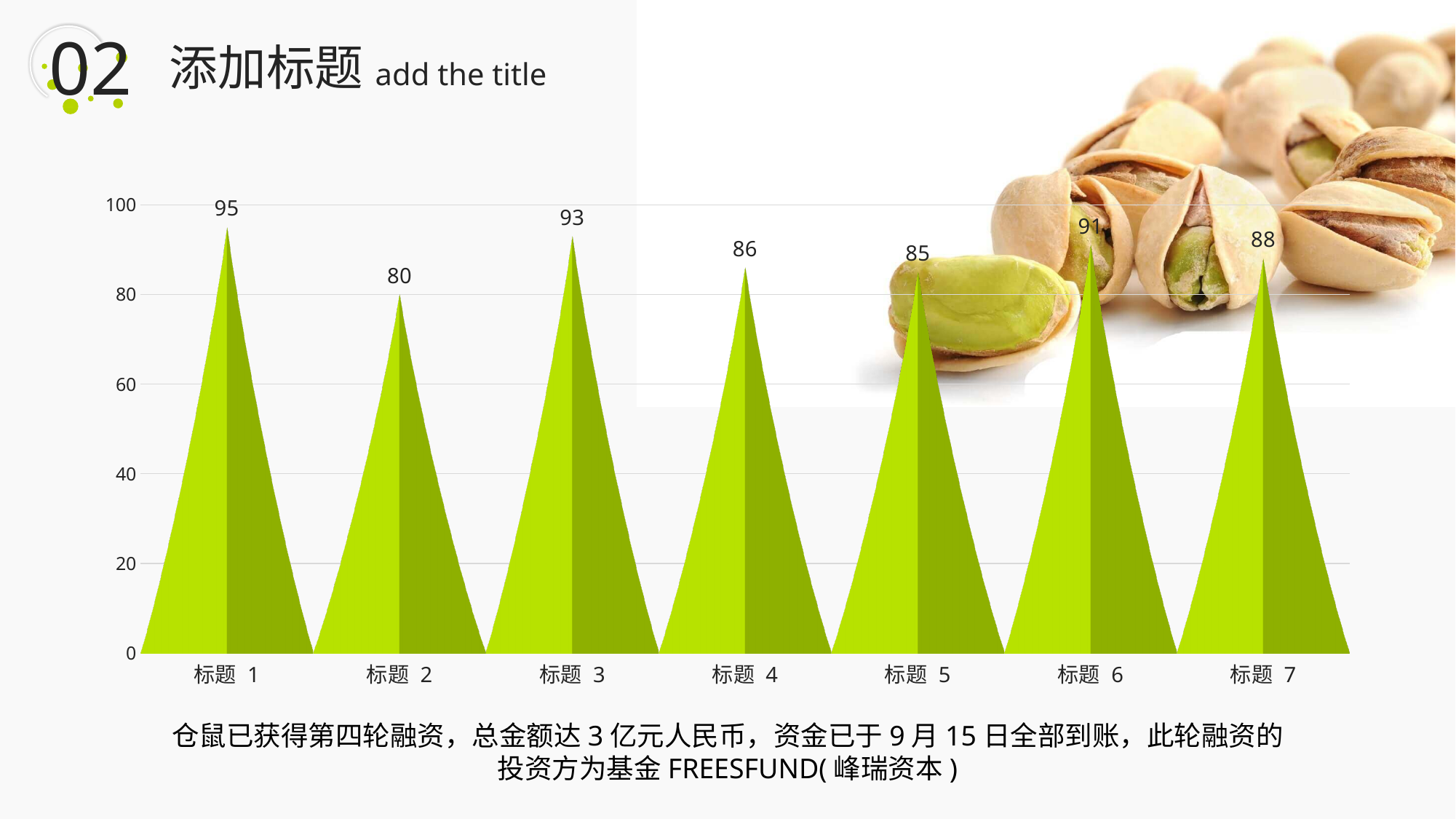
Which is larger, the value for 标题 3 or the value for 标题 5? 标题 3 How many categories are shown on the x axis? 7 What is the value for 标题 4? 86 What is the value for 标题 6? 91 What is the highest tick value shown on the vertical axis? 100 What is the value for 标题 1? 95 What is the difference between the values for 标题 3 and 标题 7? 5 What is the difference between the values for 标题 1 and 标题 2? 15 What kind of chart is shown on the slide? bar chart Is the value for 标题 2 greater or less than 60? greater Which category has the highest value? 标题 1 Which category has the lowest value? 标题 2